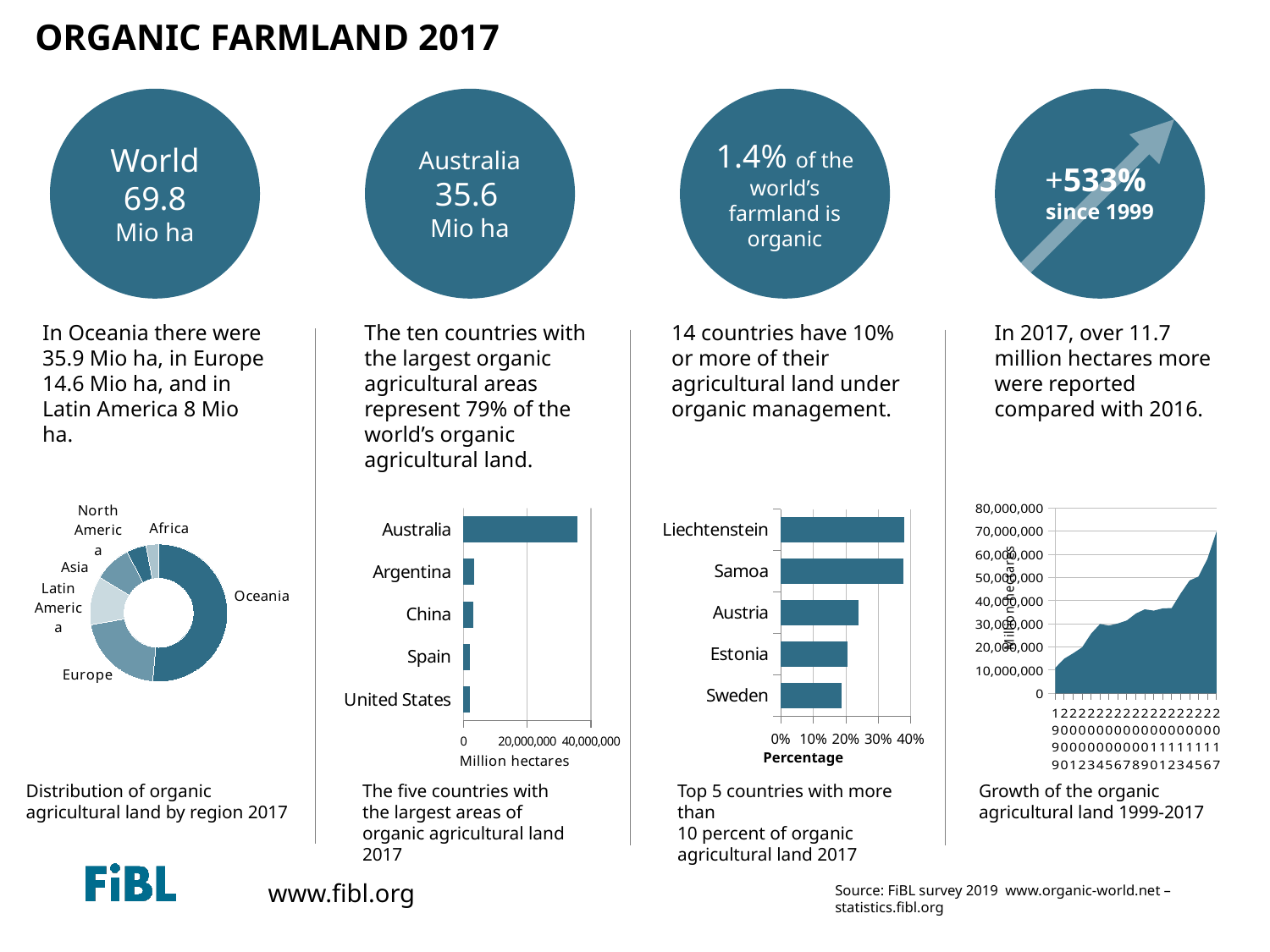
In the chart 'Top 5 countries with more than 10 percent of organic agricultural land 2017', which country has the lowest value? Sweden In the chart 'Growth of the organic agricultural land 1999-2017', do the values rise or fall over time? rise In the chart 'Top 5 countries with more than 10 percent of organic agricultural land 2017', is the value for Liechtenstein greater or less than 30%? greater In the chart 'Top 5 countries with more than 10 percent of organic agricultural land 2017', which has a larger value, Austria or Estonia? Austria What kind of chart is 'Growth of the organic agricultural land 1999-2017'? Area chart In the chart 'The five countries with the largest areas of organic agricultural land 2017', which country has the lowest value? United States How many regions are shown in the chart 'Distribution of organic agricultural land by region 2017'? 6 What kind of chart is 'Distribution of organic agricultural land by region 2017'? Doughnut (pie) chart In the chart 'The five countries with the largest areas of organic agricultural land 2017', what is the x-axis title? Million hectares In the chart 'The five countries with the largest areas of organic agricultural land 2017', which country has the highest value? Australia In the chart 'The five countries with the largest areas of organic agricultural land 2017', is the value for Australia greater or less than 20,000,000? greater In the chart 'Distribution of organic agricultural land by region 2017', which region has the largest share? Oceania